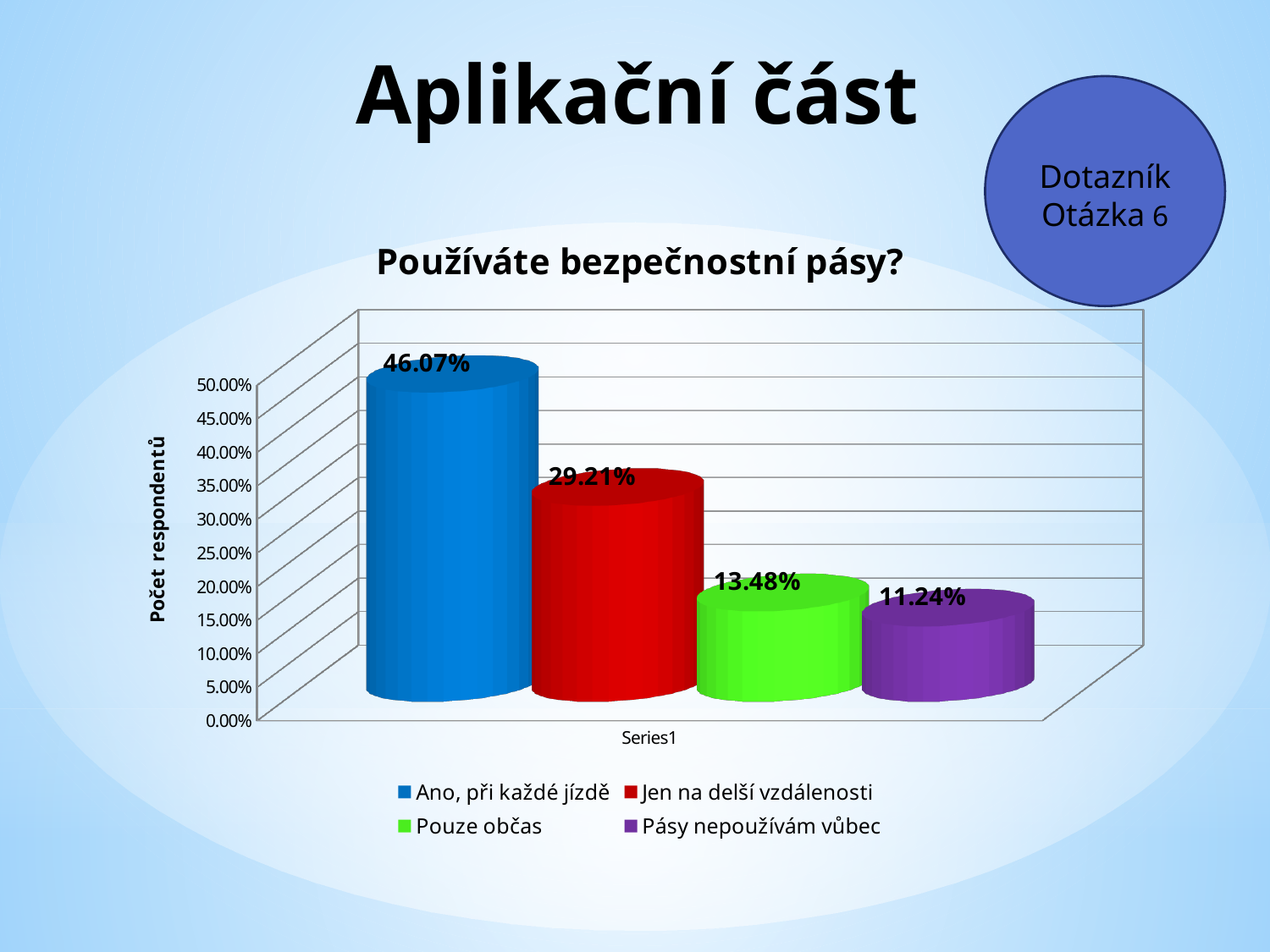
What is the difference between the values for "Ano, při každé jízdě" and "Jen na delší vzdálenosti"? 16.86% What is the value for "Pouze občas"? 13.48% How many series does the legend list? 4 What is the value for "Jen na delší vzdálenosti"? 29.21% What is the value for "Ano, při každé jízdě"? 46.07% Which response has the lowest value? Pásy nepoužívám vůbec Which is larger, the value for "Jen na delší vzdálenosti" or the value for "Pouze občas"? Jen na delší vzdálenosti What is the title of the chart? Používáte bezpečnostní pásy? What is the difference between the values for "Pouze občas" and "Pásy nepoužívám vůbec"? 2.24% Which response has the highest value? Ano, při každé jízdě What kind of chart is shown on the slide? Bar chart What is the value for "Pásy nepoužívám vůbec"? 11.24%